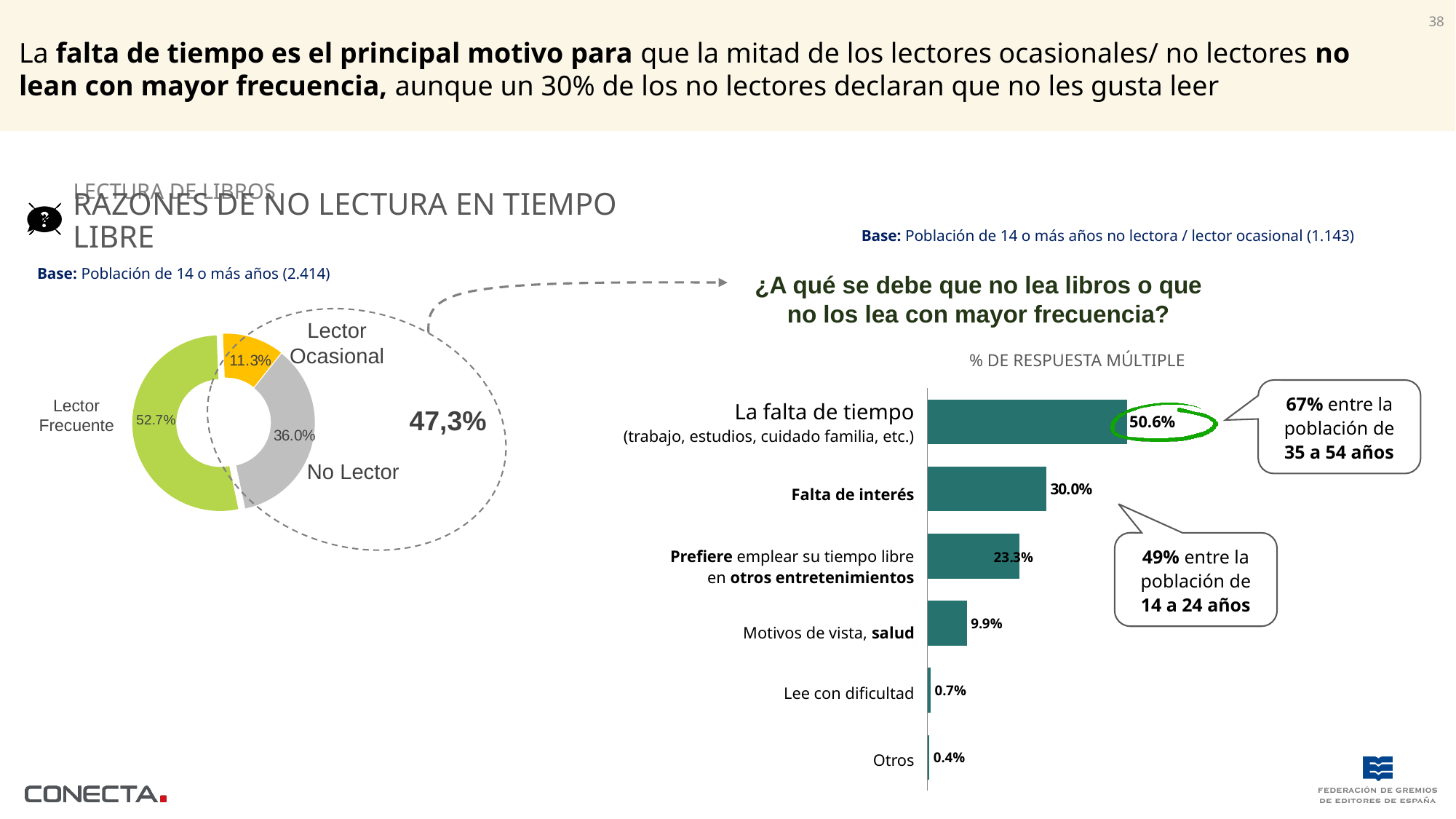
In the bar chart on the right, what is the value for 'Falta de interés'? 30.0% In the bar chart on the right, which is larger: 'Prefiere emplear su tiempo libre en otros entretenimientos' or 'Motivos de vista, salud'? Prefiere emplear su tiempo libre en otros entretenimientos In the bar chart on the right, which category has the lowest value? Otros How many categories are shown in the bar chart on the right? 6 In the donut chart on the left, which segment is the smallest? Lector Ocasional In the donut chart on the left, what is the value for 'No Lector'? 36.0% In the bar chart on the right, what is the value for 'La falta de tiempo'? 50.6% In the bar chart on the right, what is the difference between 'La falta de tiempo' and 'Falta de interés'? 20.6% In the donut chart on the left, what is the share for 'Lector Frecuente'? 52.7% What kind of chart is shown on the right side of the slide? Bar chart In the bar chart on the right, what is the value for 'Motivos de vista, salud'? 9.9% In the bar chart on the right, which category has the highest value? La falta de tiempo